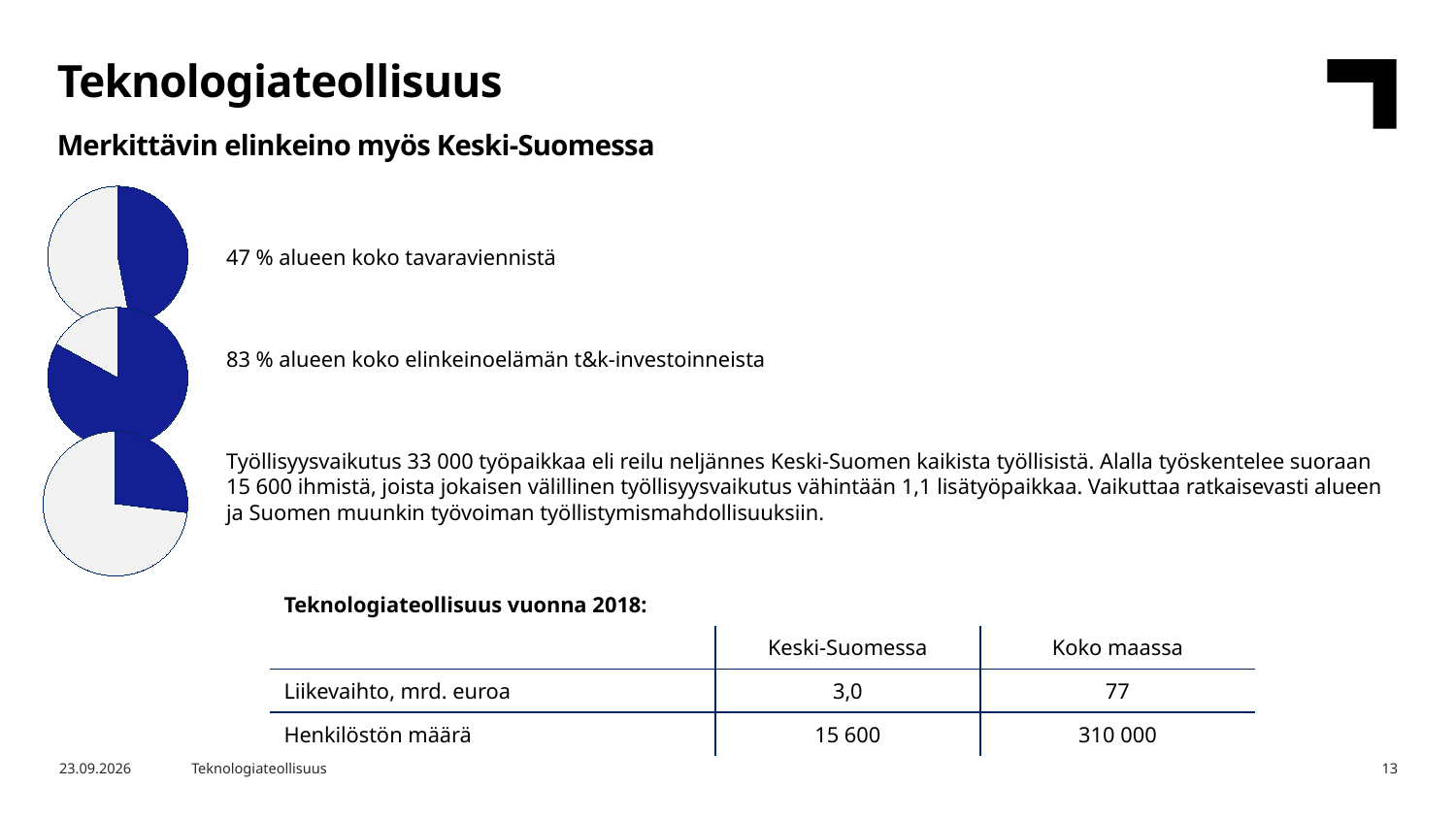
Which of the three pie charts has the largest highlighted share? The middle one (83 %) How many pie charts are on the slide? 3 Which of the three pie charts has the smallest highlighted share? The bottom one What colour is used for the highlighted slice in the pie charts? Blue Which pie chart has the larger highlighted slice, the top one or the middle one? The middle one In the bottom pie chart, is the highlighted slice greater or less than 50 %? less What is the difference in percentage points between the highlighted shares of the middle pie chart (83 %) and the top pie chart (47 %)? 36 percentage points In the middle pie chart, what share of the region's business R&D investments (elinkeinoelämän t&k-investoinnit) does the highlighted slice represent? 83 % In the middle pie chart, is the highlighted slice greater or less than 50 %? greater In the top pie chart, what share of the region's total goods exports (alueen koko tavaravienti) does the highlighted slice represent? 47 % What kind of charts are shown on the left side of the slide? Pie charts What does the top pie chart illustrate, according to the text next to it? 47 % alueen koko tavaraviennistä